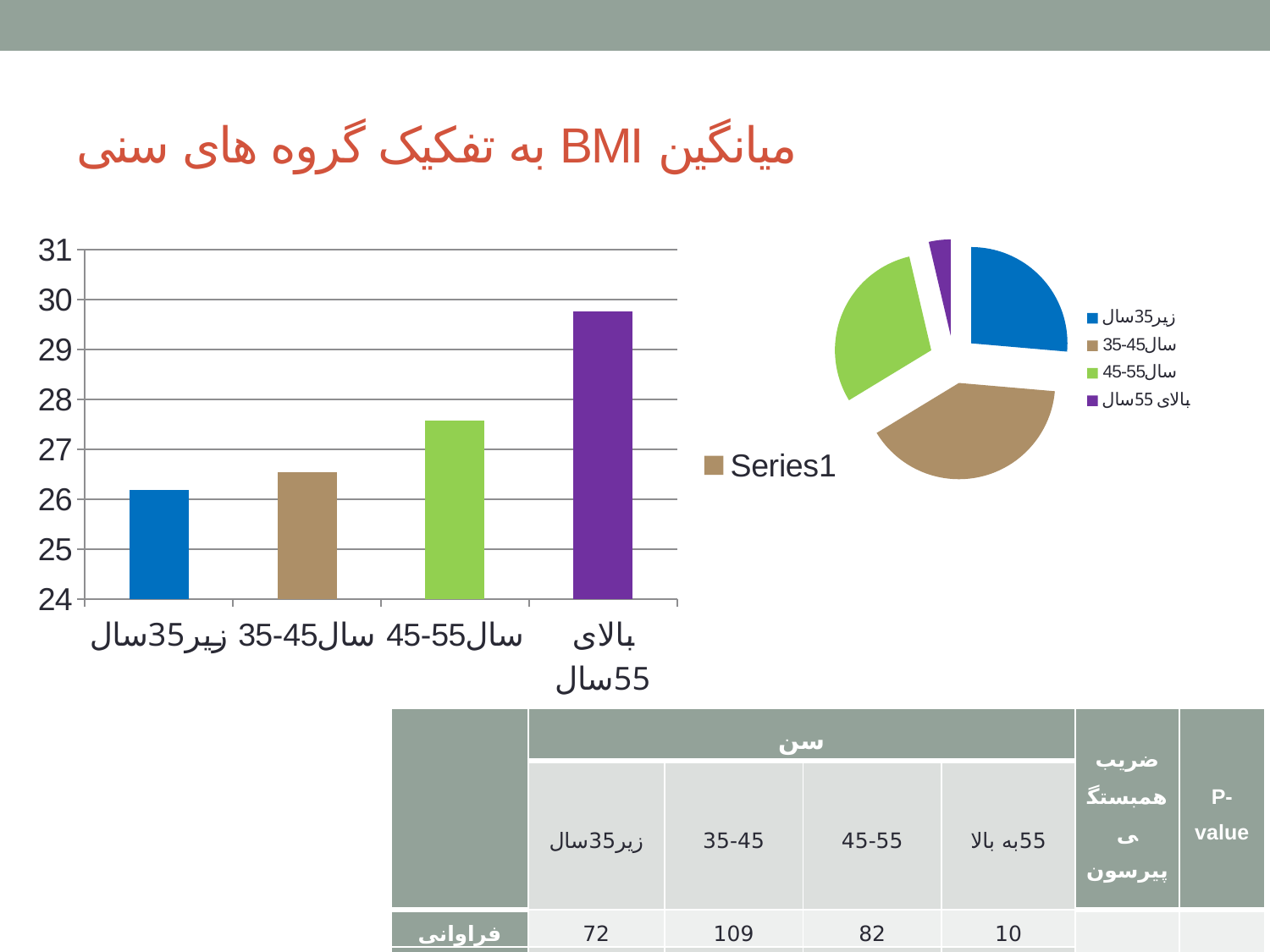
In the bar chart on the left, which is larger, the value for 45-55 سال or the value for 35-45 سال? 45-55 سال What kind of chart is the chart on the left of the slide? bar chart In the bar chart on the left, is the value for بالای 55سال greater or less than 29? greater In the bar chart on the left, what is the name of the series shown in the legend? Series1 In the bar chart on the left, which age group has the highest bar? بالای 55سال In the pie chart on the right, which age group has the largest slice? 35-45سال In the bar chart on the left, how many age-group categories are shown on the x axis? 4 In the bar chart on the left, how many series does the legend list? 1 What kind of chart is the chart on the right of the slide? pie chart In the bar chart on the left, do the bar values rise or fall from the youngest age group to the oldest? rise In the bar chart on the left, is the value for زیر35سال greater or less than 27? less In the bar chart on the left, which age group has the lowest bar? زیر35سال